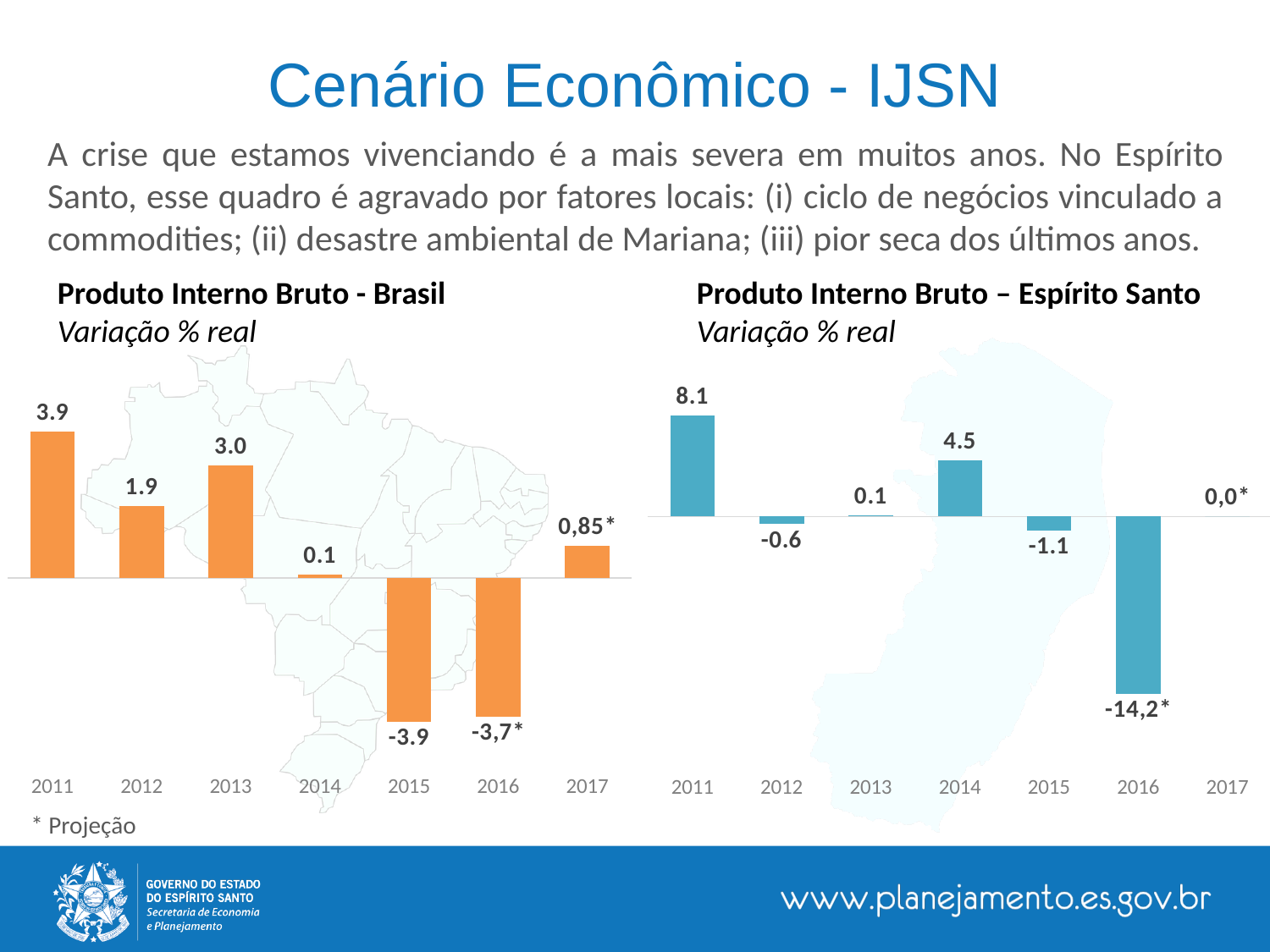
In the 'Produto Interno Bruto – Espírito Santo' chart, what is the value for 2012? -0.6 In the 'Produto Interno Bruto – Espírito Santo' chart, which is larger, the value for 2011 or the value for 2014? 2011 What kind of chart is the 'Produto Interno Bruto – Espírito Santo' chart? Bar chart In the 'Produto Interno Bruto – Espírito Santo' chart, what is the projected value for 2016? -14,2* In the 'Produto Interno Bruto – Espírito Santo' chart, what is the value for 2014? 4.5 In the 'Produto Interno Bruto - Brasil' chart, what is the difference between the 2011 value and the 2012 value? 2.0 In the 'Produto Interno Bruto - Brasil' chart, do the values rise or fall from 2011 to 2015? Fall In the 'Produto Interno Bruto – Espírito Santo' chart, which year has the lowest value? 2016 What colour are the bars in the 'Produto Interno Bruto - Brasil' chart? Orange In the 'Produto Interno Bruto - Brasil' chart, which year has the highest value? 2011 How many years are shown on the x axis of the 'Produto Interno Bruto - Brasil' chart? 7 In the 'Produto Interno Bruto - Brasil' chart, what is the value for 2013? 3.0